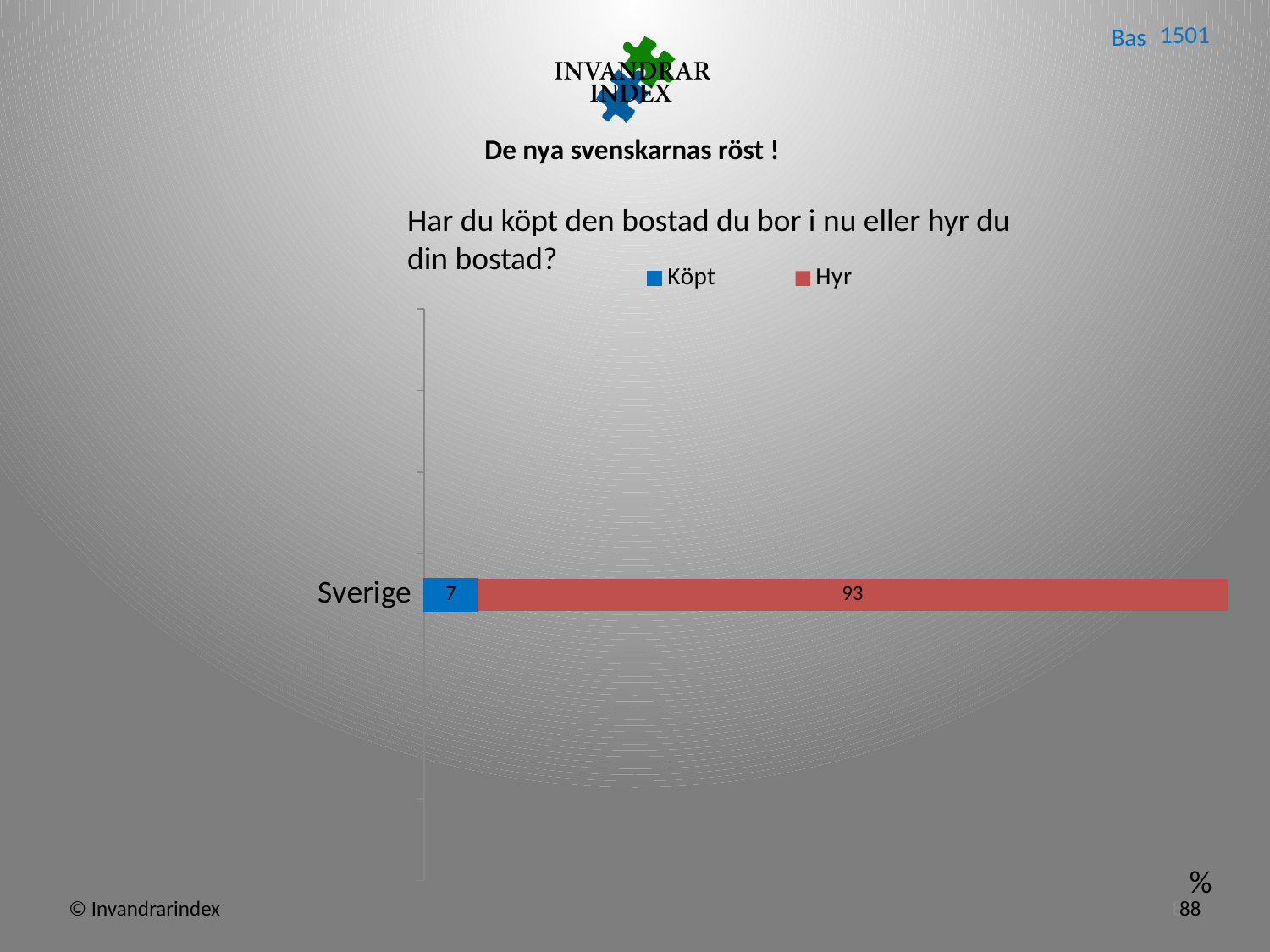
How many categories are shown on the chart? 1 Which series is shown in red in the legend? Hyr What is the value for Hyr for Sverige? 93 What kind of chart is shown on the slide? Bar chart How many series does the legend list? 2 What is the total of the stacked bar for Sverige? 100 What is the title of the chart? Har du köpt den bostad du bor i nu eller hyr du din bostad? What is the difference between the Hyr and Köpt values for Sverige? 86 Which series has the larger value for Sverige, Köpt or Hyr? Hyr Which series has the smallest value for Sverige? Köpt What is the value for Köpt for Sverige? 7